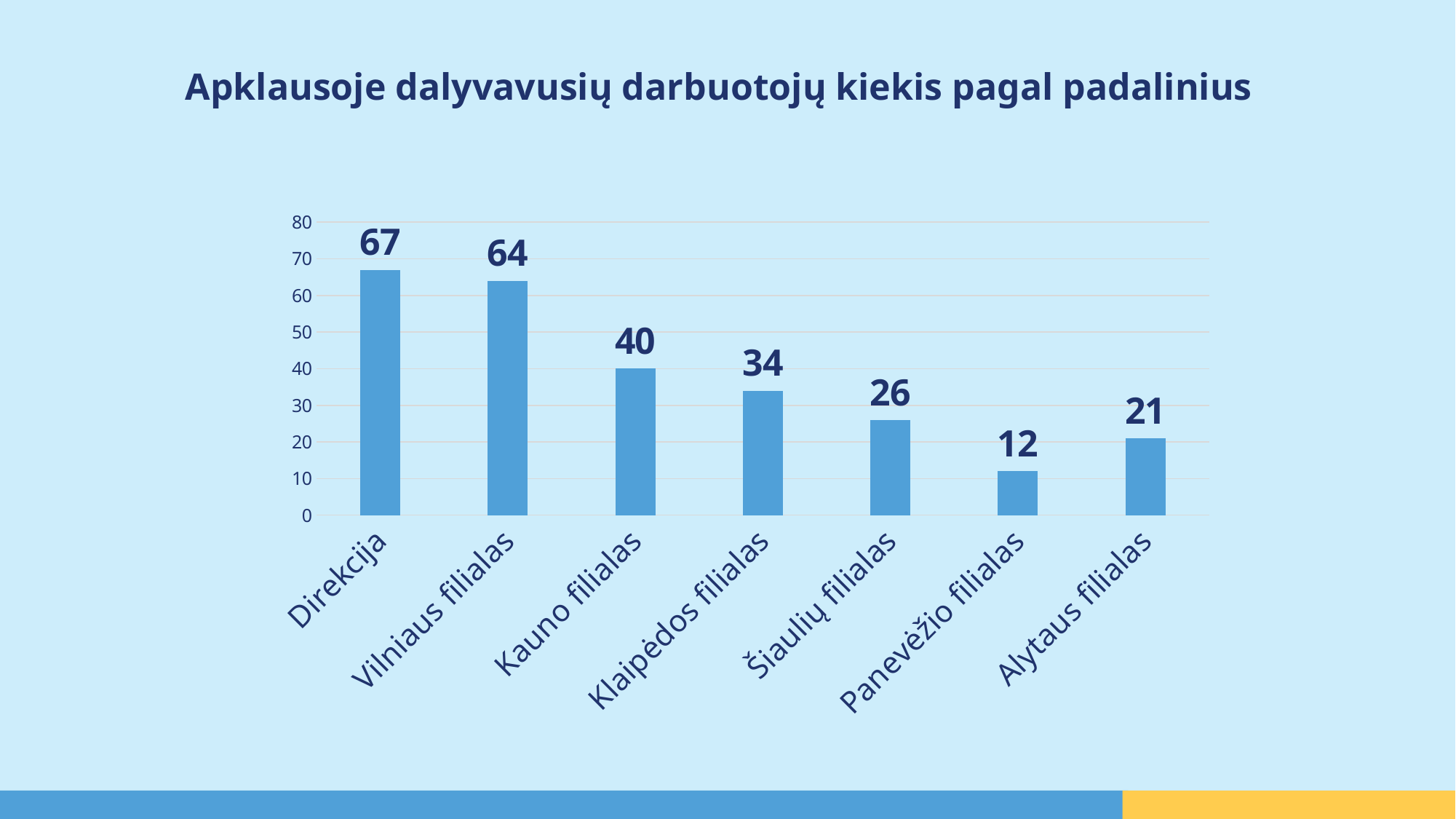
What is the difference between the values for Direkcija and Vilniaus filialas? 3 What is the value for Direkcija? 67 What is the title of the chart? Apklausoje dalyvavusių darbuotojų kiekis pagal padalinius How many categories are shown on the x axis? 7 What kind of chart is shown on the slide? bar chart Which category has the lowest value? Panevėžio filialas Do the values generally rise or fall from left to right along the x axis? fall What is the value for Panevėžio filialas? 12 What is the value for Kauno filialas? 40 Which category has the highest value? Direkcija What is the difference between the values for Klaipėdos filialas and Alytaus filialas? 13 Which is larger, the value for Šiaulių filialas or the value for Alytaus filialas? Šiaulių filialas